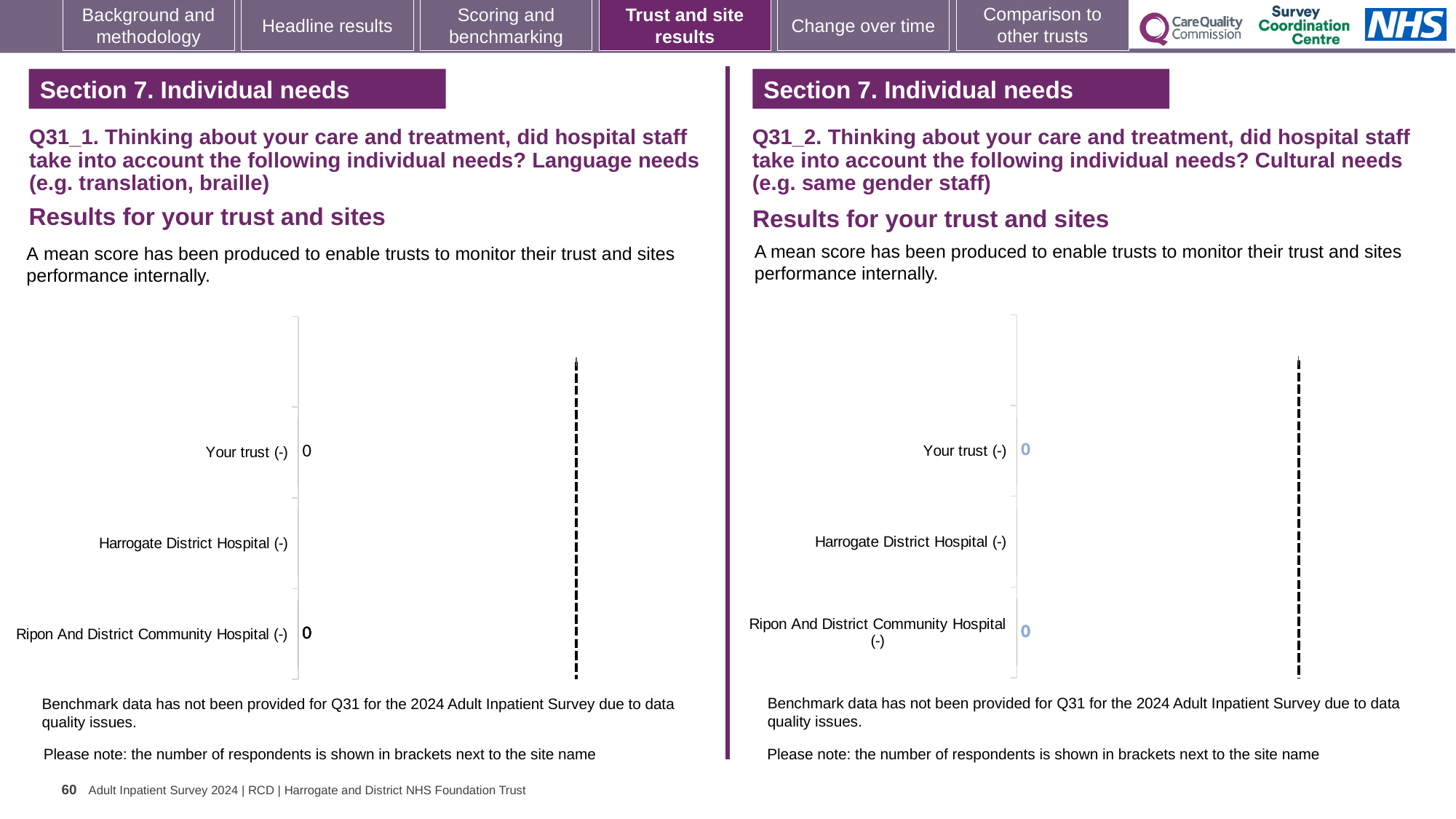
What kind of chart is used on the left side of the slide for Q31_1? Bar chart On the left chart (Q31_1, Language needs), what value is shown for Your trust (-)? 0 Which individual need does the question for the left chart (Q31_1) refer to? Language needs (e.g. translation, braille) On the right chart (Q31_2, Cultural needs), which category is listed in the middle of the vertical axis? Harrogate District Hospital (-) On the right chart (Q31_2, Cultural needs), what value is shown for Your trust (-)? 0 On the left chart (Q31_1, Language needs), what is the difference between the values for Your trust (-) and Ripon And District Community Hospital (-)? 0 On the right chart (Q31_2, Cultural needs), how many categories are listed on the vertical axis? 3 On the left chart (Q31_1, Language needs), how many categories are listed on the vertical axis? 3 On the right chart (Q31_2, Cultural needs), what value is shown for Ripon And District Community Hospital (-)? 0 On the left chart (Q31_1, Language needs), what value is shown for Ripon And District Community Hospital (-)? 0